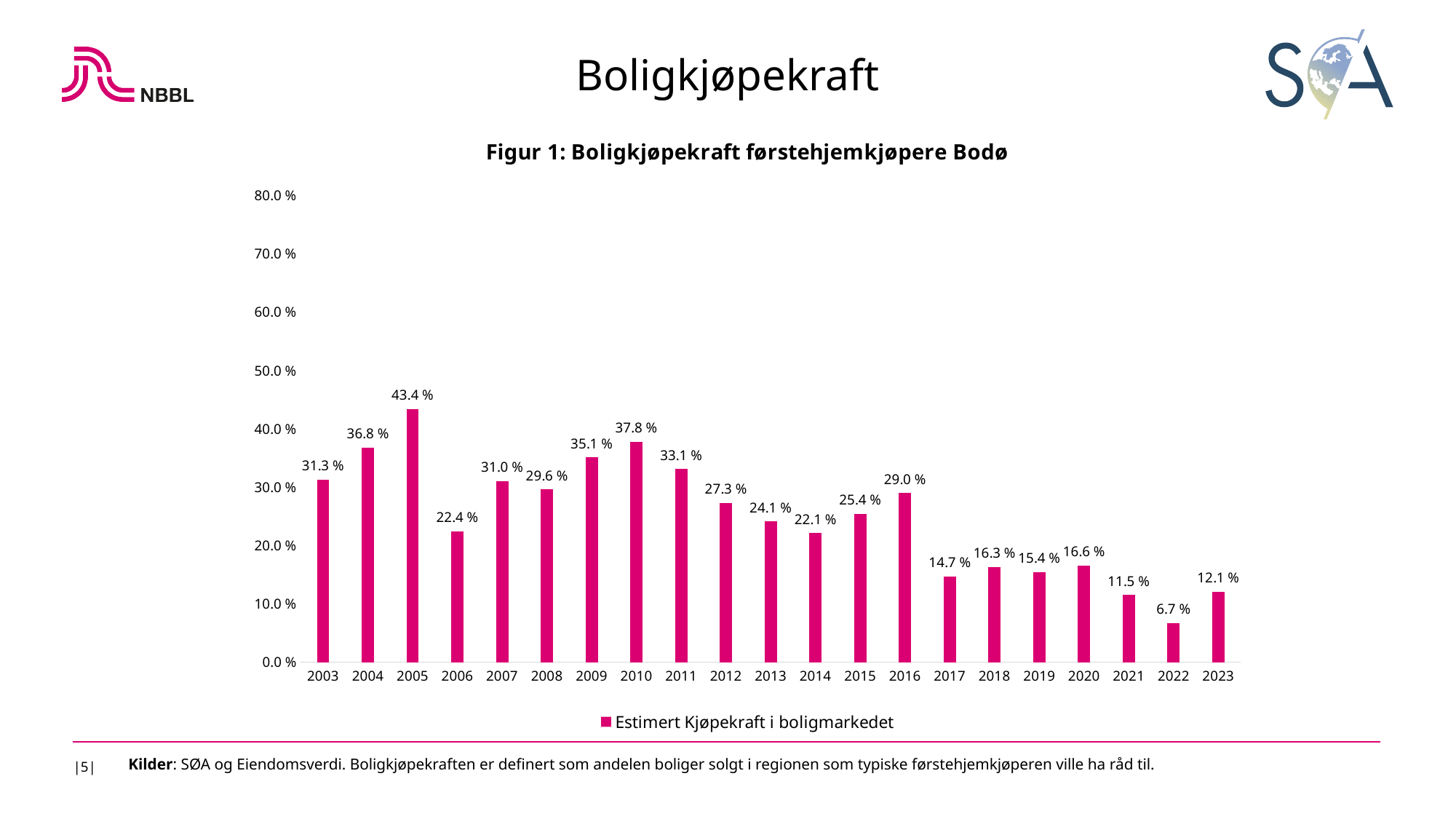
What is the value for 2022? 6.7 % What is the difference between the values for 2005 and 2023? 31.3 % Which year has the lowest value? 2022 How many years are shown on the x axis? 21 What is the title of the chart? Figur 1: Boligkjøpekraft førstehjemkjøpere Bodø What is the value for 2005? 43.4 % What kind of chart is shown? bar chart Which is larger, the value for 2010 or the value for 2011? 2010 What is the value for 2016? 29.0 % Is the value for 2004 greater or less than 30.0 %? greater How many series does the legend list? 1 Which year has the highest value? 2005